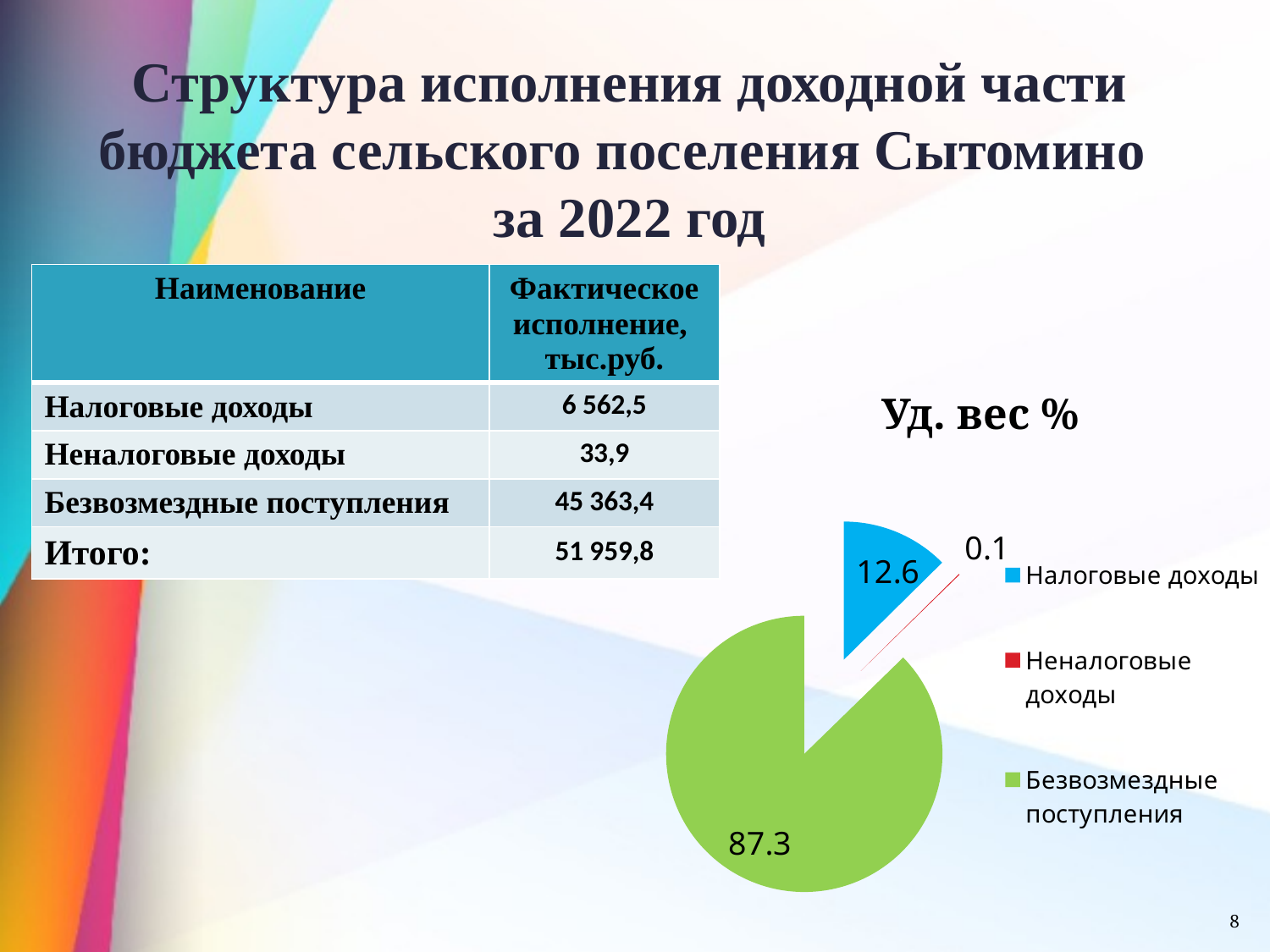
Which is larger in the pie chart: Налоговые доходы or Неналоговые доходы? Налоговые доходы What is the difference between the shares of Безвозмездные поступления and Налоговые доходы in the pie chart? 74.7 What colour is the slice for Безвозмездные поступления in the pie chart? green How many slices does the pie chart have? 3 Which category has the smallest slice in the pie chart? Неналоговые доходы What share does Безвозмездные поступления have in the pie chart? 87.3 How many entries does the legend of the pie chart list? 3 What is the title of the pie chart? Уд. вес % Which category has the largest slice in the pie chart? Безвозмездные поступления What share does Неналоговые доходы have in the pie chart? 0.1 What share does Налоговые доходы have in the pie chart? 12.6 What kind of chart is shown on the slide? pie chart